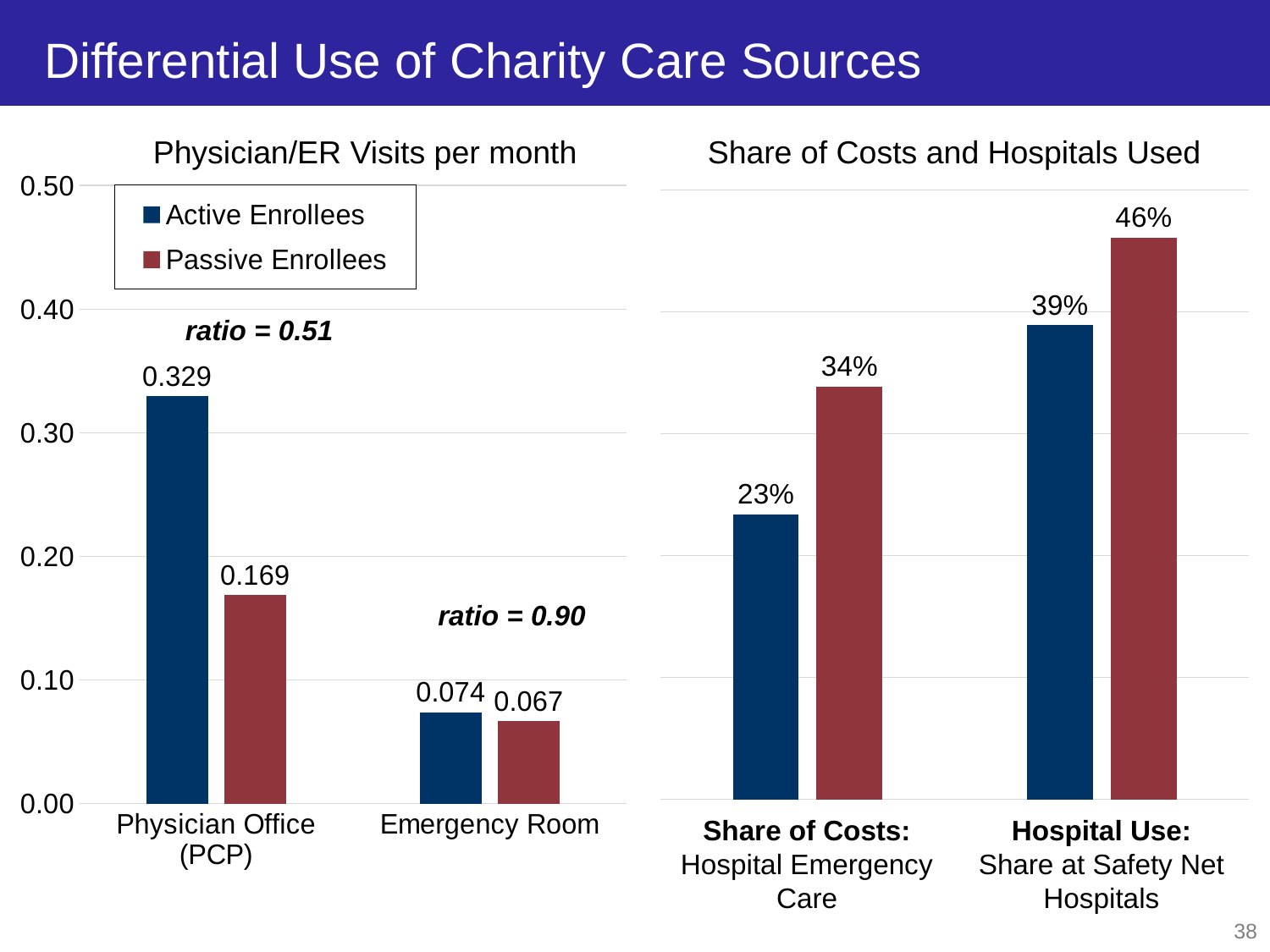
In the 'Physician/ER Visits per month' chart, what ratio is shown above the Physician Office (PCP) bars? ratio = 0.51 In the 'Share of Costs and Hospitals Used' chart, what is the difference between Passive Enrollees and Active Enrollees for Share of Costs: Hospital Emergency Care? 11% In the 'Physician/ER Visits per month' chart, how many series does the legend list? 2 In the 'Physician/ER Visits per month' chart, what is the value for Active Enrollees at Physician Office (PCP)? 0.329 In the 'Share of Costs and Hospitals Used' chart, how many categories are shown on the x axis? 2 In the 'Physician/ER Visits per month' chart, what is the value for Passive Enrollees at Emergency Room? 0.067 In the 'Share of Costs and Hospitals Used' chart, what is the value for Passive Enrollees for Hospital Use: Share at Safety Net Hospitals? 46% In the 'Share of Costs and Hospitals Used' chart, what is the value for Active Enrollees for Share of Costs: Hospital Emergency Care? 23% In the 'Physician/ER Visits per month' chart, which series has the higher value at Emergency Room? Active Enrollees In the 'Physician/ER Visits per month' chart, what is the difference between Active Enrollees and Passive Enrollees at Physician Office (PCP)? 0.160 In the 'Share of Costs and Hospitals Used' chart, which bar has the highest value? Passive Enrollees, Hospital Use: Share at Safety Net Hospitals What kind of chart is the 'Physician/ER Visits per month' chart? Bar chart